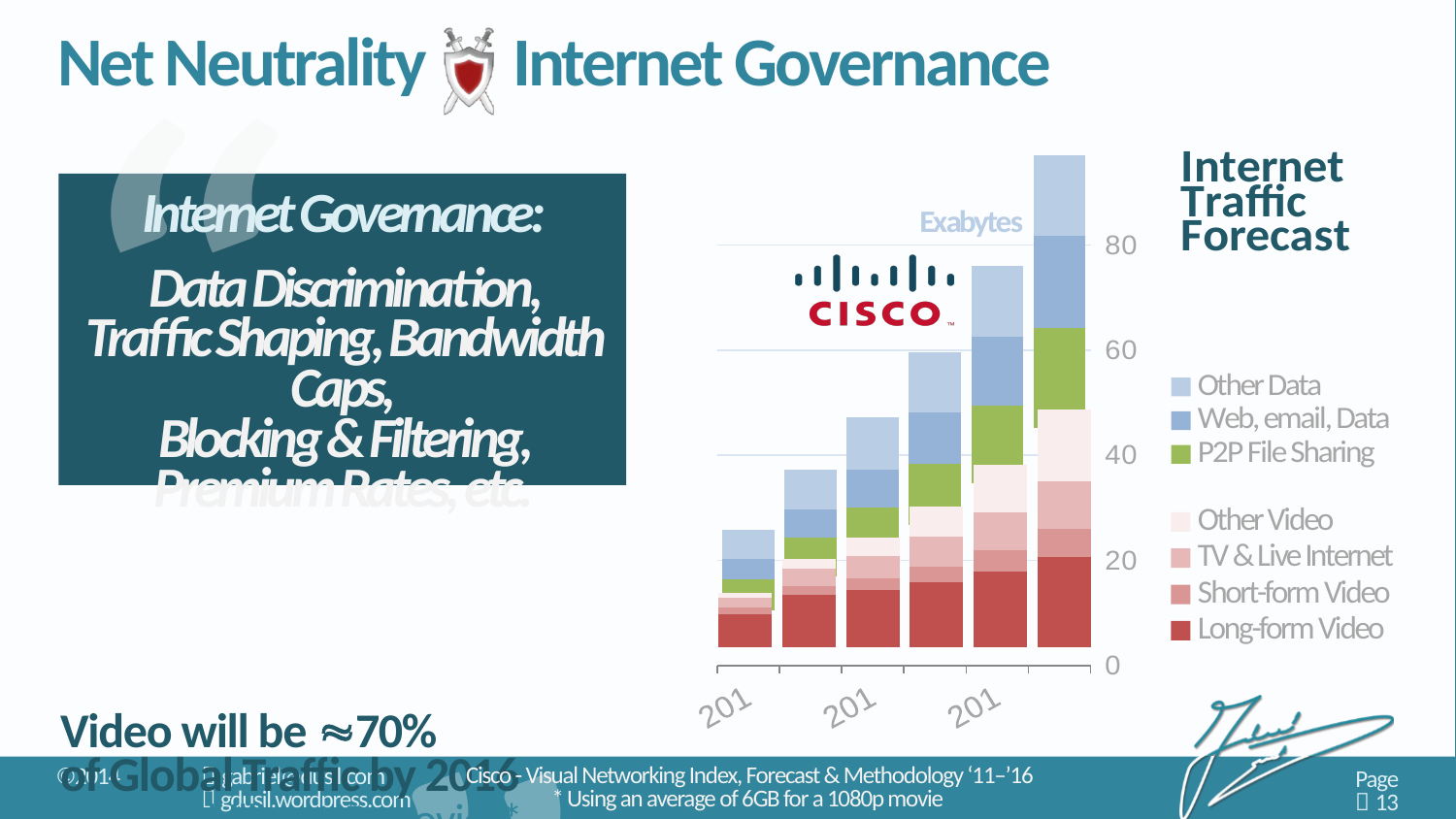
Is the total of the rightmost bar in the Internet Traffic Forecast chart greater or less than 80? greater Is the total of the second bar from the left in the Internet Traffic Forecast chart greater or less than 40? less How many bars are plotted in the Internet Traffic Forecast chart? 6 Which bar in the Internet Traffic Forecast chart has the highest total? the rightmost bar Which bar in the Internet Traffic Forecast chart has the lowest total? the leftmost bar Do the bar totals in the Internet Traffic Forecast chart rise or fall from left to right? rise Is the total of the leftmost bar in the Internet Traffic Forecast chart greater or less than 40? less What unit is shown on the Internet Traffic Forecast chart? Exabytes Which legend entry in the Internet Traffic Forecast chart is shown at the bottom of each stacked bar? Long-form Video How many series does the legend of the Internet Traffic Forecast chart list? 7 What kind of chart is the Internet Traffic Forecast chart? stacked bar chart